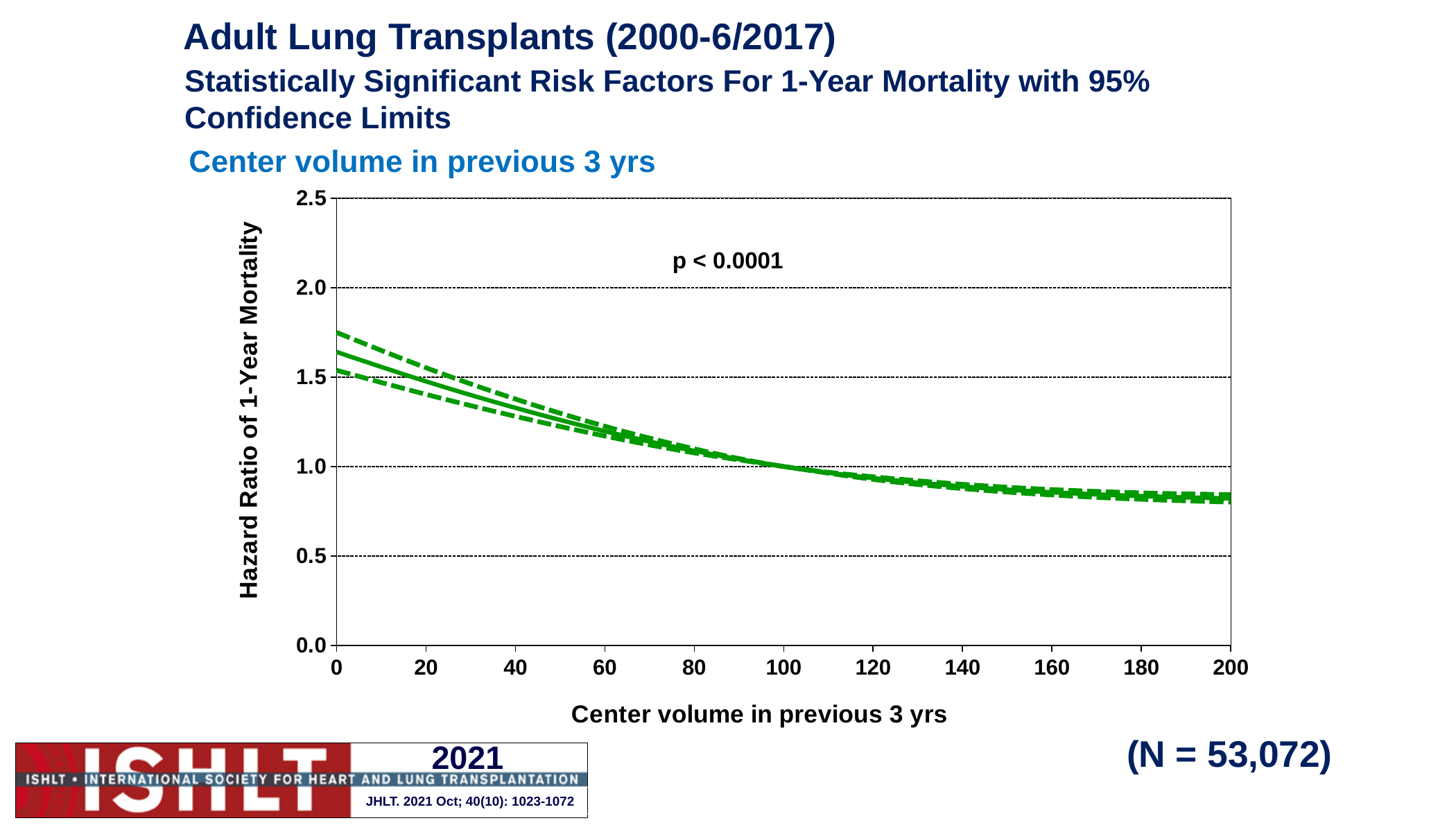
What p-value is printed on the chart? p < 0.0001 At which end of the x axis, center volume 0 or 200, is the hazard ratio lowest? 200 Is the hazard ratio at a center volume of 200 greater or less than 1.0? less Is the hazard ratio at a center volume of 140 greater or less than 1.0? less How does the hazard ratio of 1-year mortality change as center volume in previous 3 yrs increases from 0 to 200? It falls Is the hazard ratio at a center volume of 0 greater or less than 1.5? greater Which has the larger hazard ratio: a center volume of 20 or a center volume of 120? 20 At which end of the x axis, center volume 0 or 200, is the hazard ratio highest? 0 What kind of chart is shown on the slide? line chart How many lines (estimate plus confidence limits) are plotted on the chart? 3